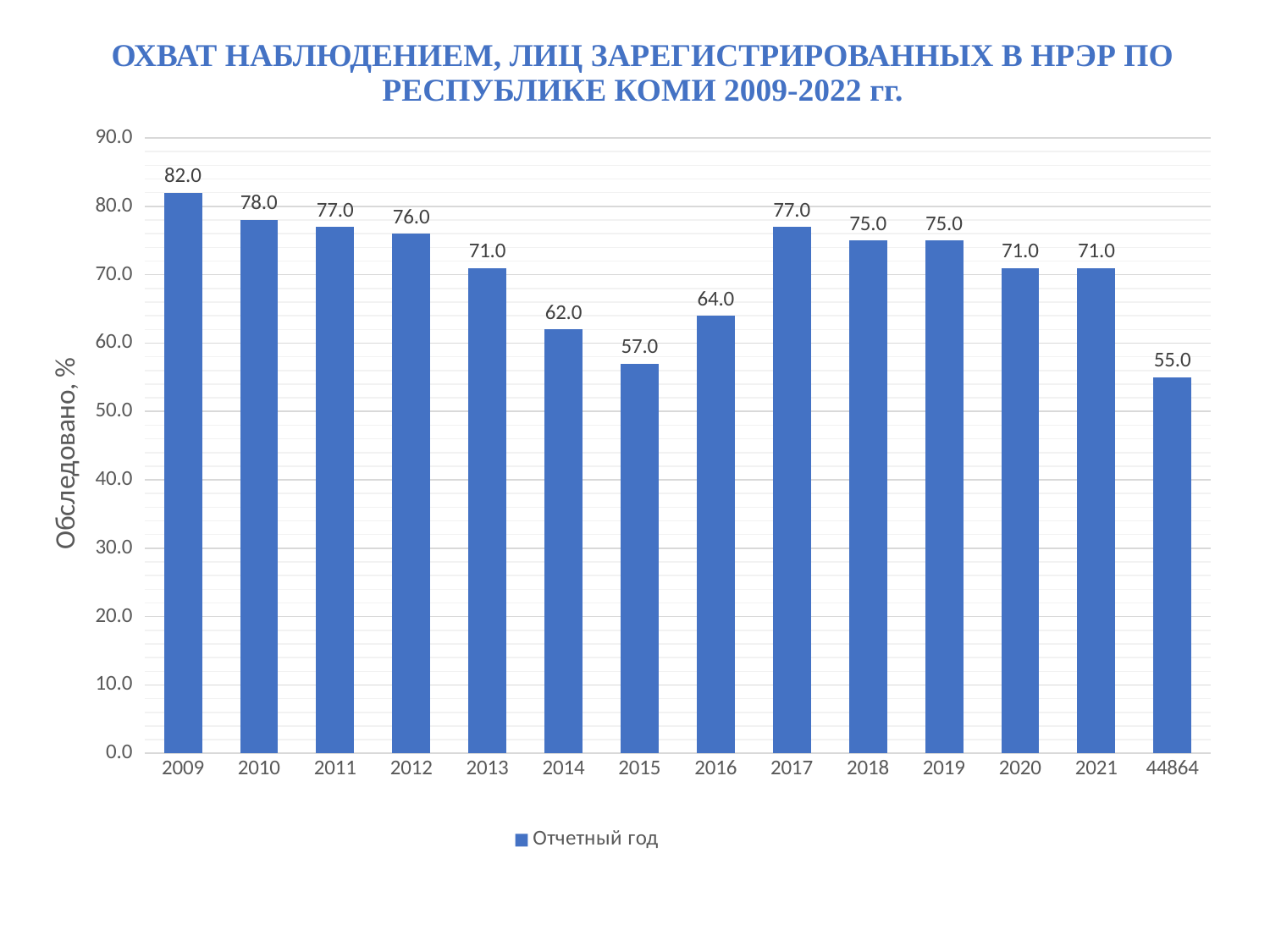
What kind of chart is shown? bar chart Which category has the highest value? 2009 How many bars are shown in the chart? 14 How many series does the legend list? 1 What is the difference between the values for 2009 and 2015? 25.0 What is the y-axis label of the chart? Обследовано, % What is the value for 2017? 77.0 What is the value for 2009? 82.0 Which is larger, the value for 2014 or the value for 2016? 2016 Which category has the lowest value? 44864 What is the value for 2015? 57.0 What is the value for the category labelled 44864? 55.0